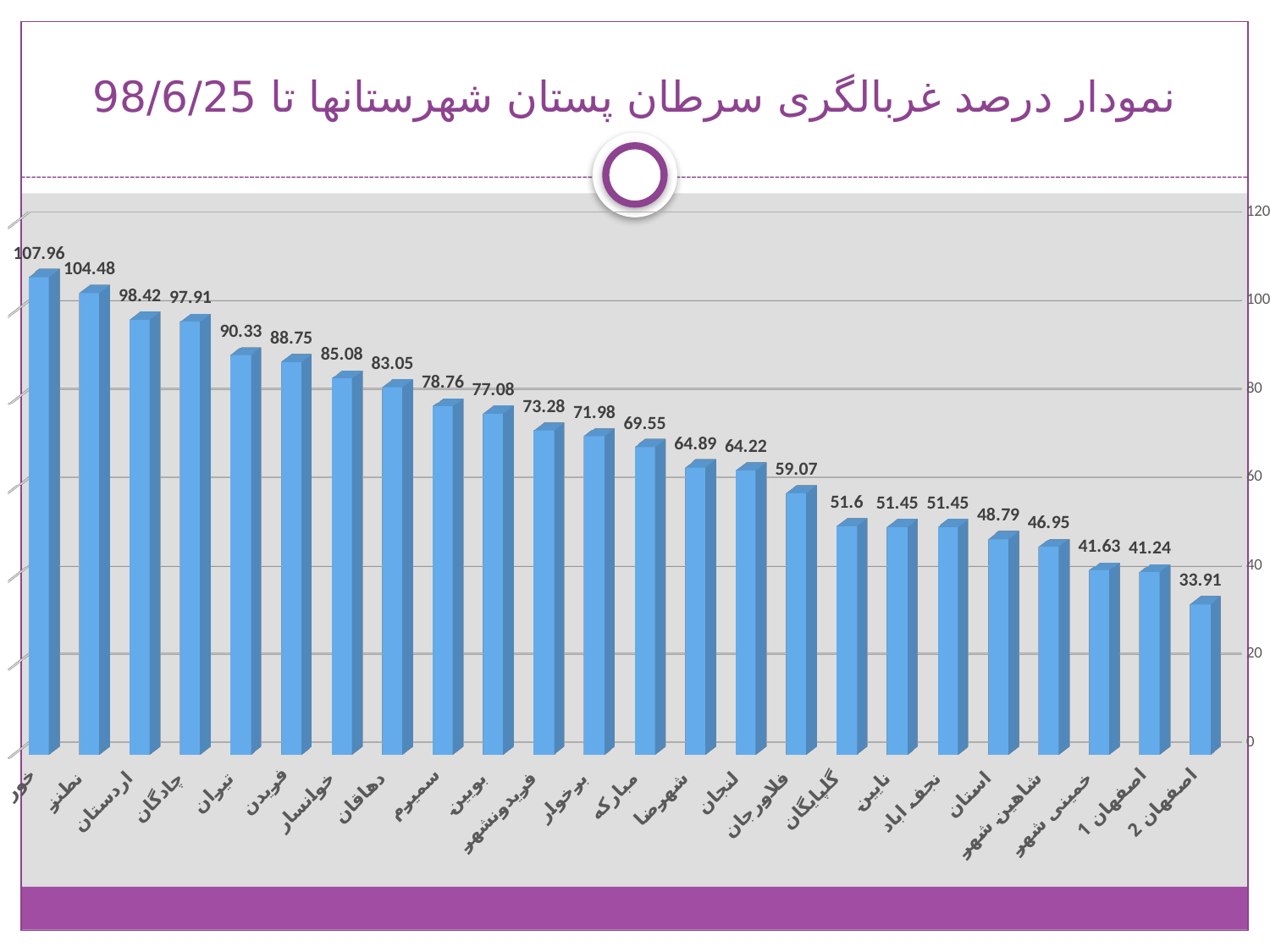
What is the value for نطنز? 104.48 What is the value for مبارکه? 69.55 Which is larger, the value for فلاورجان or the value for گلپایگان? فلاورجان Do the values rise or fall from left to right along the x axis? fall What is the title of the slide? نمودار درصد غربالگری سرطان پستان شهرستانها تا 98/6/25 What type of chart is shown on the slide? bar chart How many categories (bars) are shown in the chart? 24 What is the difference between the values for خور and اصفهان 2? 74.05 What is the value for اصفهان 2? 33.91 Which category has the lowest value? اصفهان 2 Which category has the highest value? خور Is the value for استان greater or less than 60? less